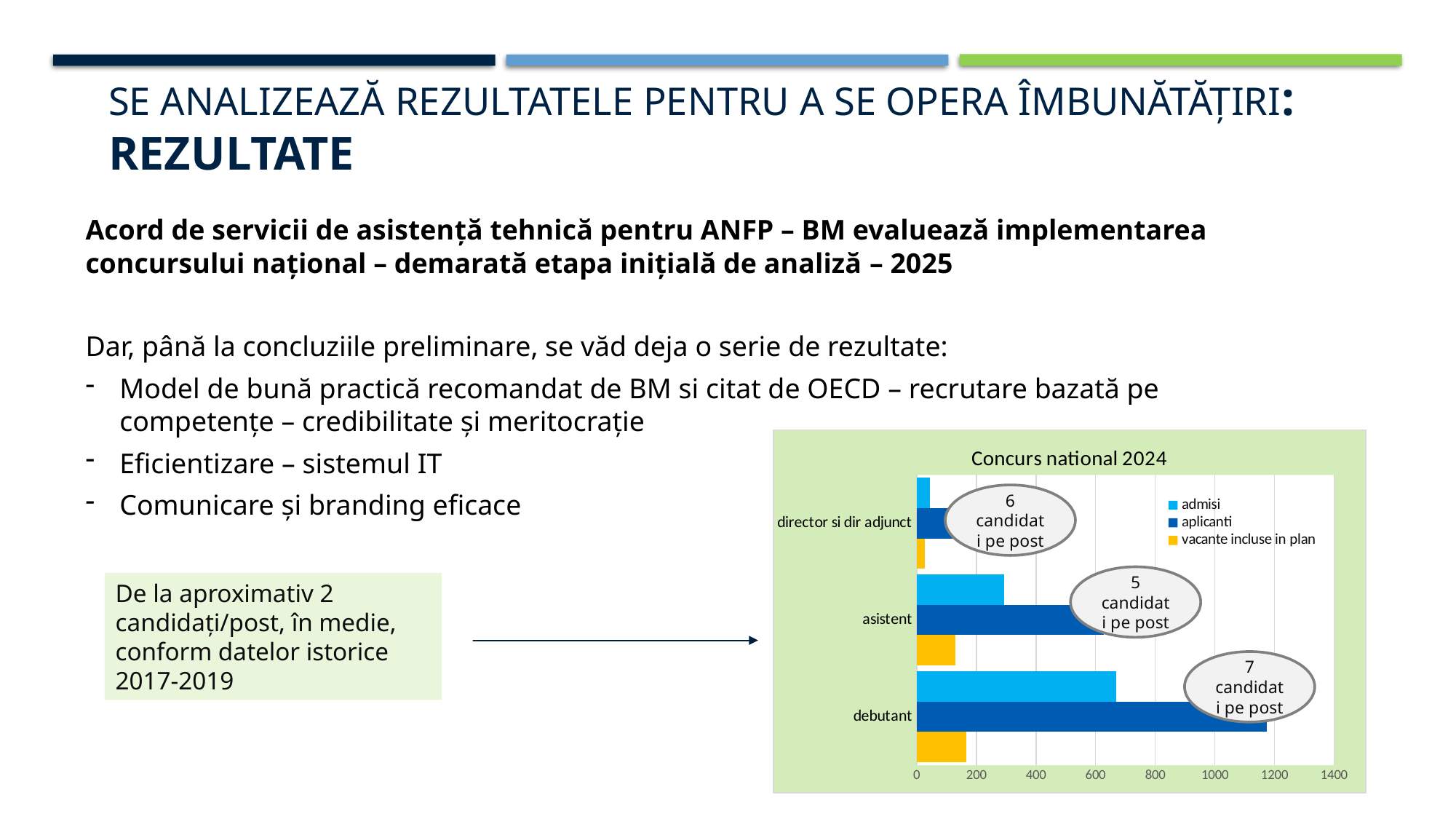
Is the admisi value for director si dir adjunct greater or less than 200? less Which category has the highest value for the aplicanti series? debutant Which category has the lowest value for the admisi series? director si dir adjunct What kind of chart is shown on the slide? bar chart Which series is shown in yellow in the chart legend? vacante incluse in plan What is the title of the chart? Concurs national 2024 How many categories are shown on the chart's vertical axis? 3 Is the aplicanti value for debutant greater or less than 1000? greater Which is larger, the admisi value for debutant or the admisi value for asistent? debutant According to the callout on the chart, how many candidates per post were there for debutant? 7 How many series does the chart legend list? 3 Is the admisi value for debutant greater or less than 600? greater